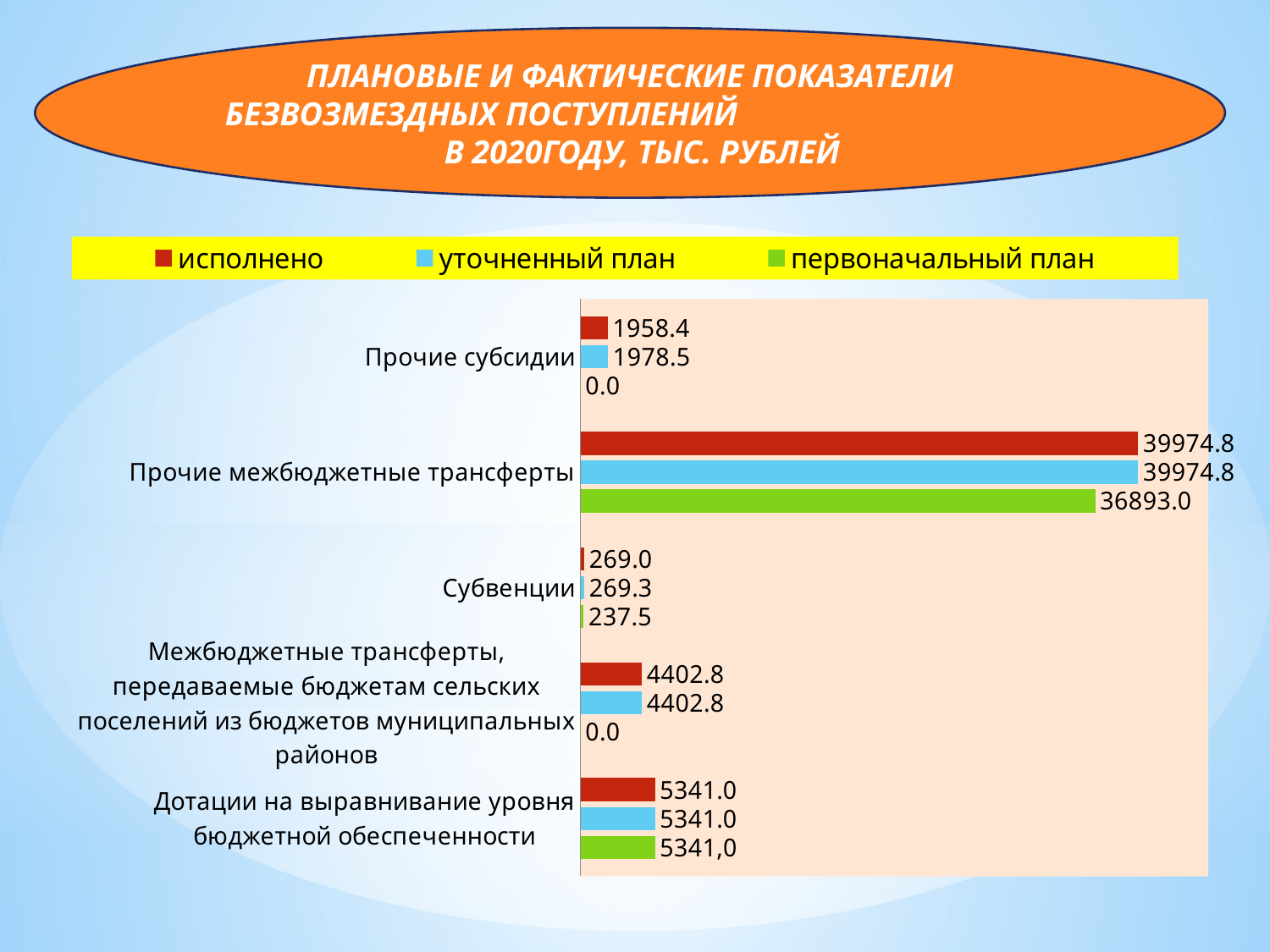
How many categories are shown on the chart? 5 Which category has the highest 'исполнено' value? Прочие межбюджетные трансферты Which category has the lowest 'исполнено' value? Субвенции How many series does the legend list? 3 What is the value of 'исполнено' for 'Прочие субсидии'? 1958.4 What is the difference between 'уточненный план' and 'первоначальный план' for 'Прочие межбюджетные трансферты'? 3081.8 Which is larger for 'Субвенции': 'исполнено' or 'первоначальный план'? исполнено Which series is shown in red in the legend? исполнено What is the value of 'первоначальный план' for 'Прочие межбюджетные трансферты'? 36893.0 What is the value of 'уточненный план' for 'Прочие субсидии'? 1978.5 What is the value of 'уточненный план' for 'Субвенции'? 269.3 What type of chart is shown on the slide? bar chart